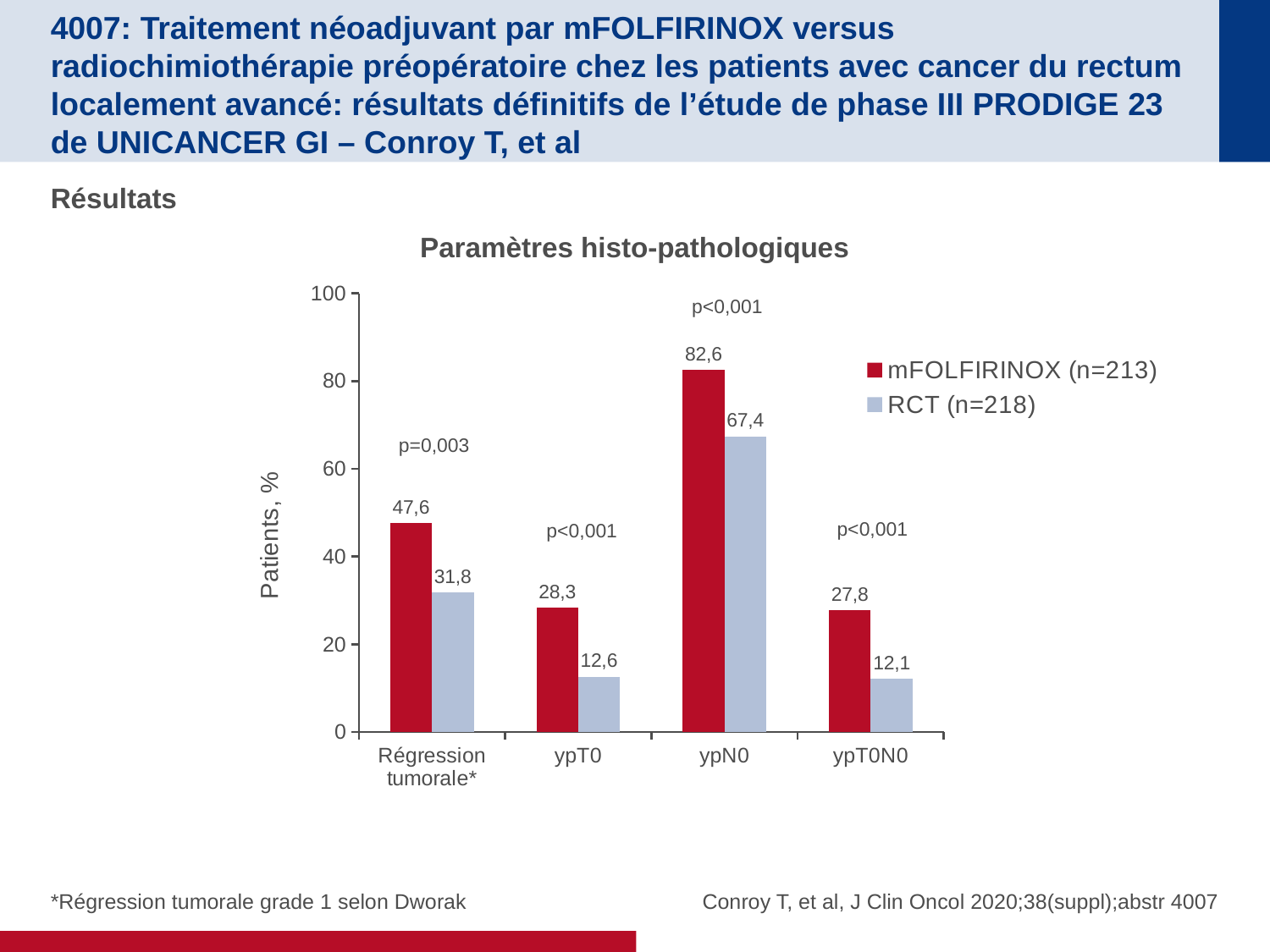
Is the value for mFOLFIRINOX (n=213) in the Régression tumorale* category greater or less than 40? greater What is the difference between mFOLFIRINOX (n=213) and RCT (n=218) in the ypT0N0 category? 15,7 Which category has the highest value for mFOLFIRINOX (n=213)? ypN0 What is the value for RCT (n=218) in the Régression tumorale* category? 31,8 What is the value for RCT (n=218) in the ypT0 category? 12,6 How many series does the legend list? 2 What kind of chart is shown on the slide? Bar chart Which category has the lowest value for RCT (n=218)? ypT0N0 What is the title of the chart? Paramètres histo-pathologiques How many categories are shown on the x axis? 4 Which series has the larger value in the ypN0 category, mFOLFIRINOX (n=213) or RCT (n=218)? mFOLFIRINOX (n=213) What is the value for mFOLFIRINOX (n=213) in the ypN0 category? 82,6